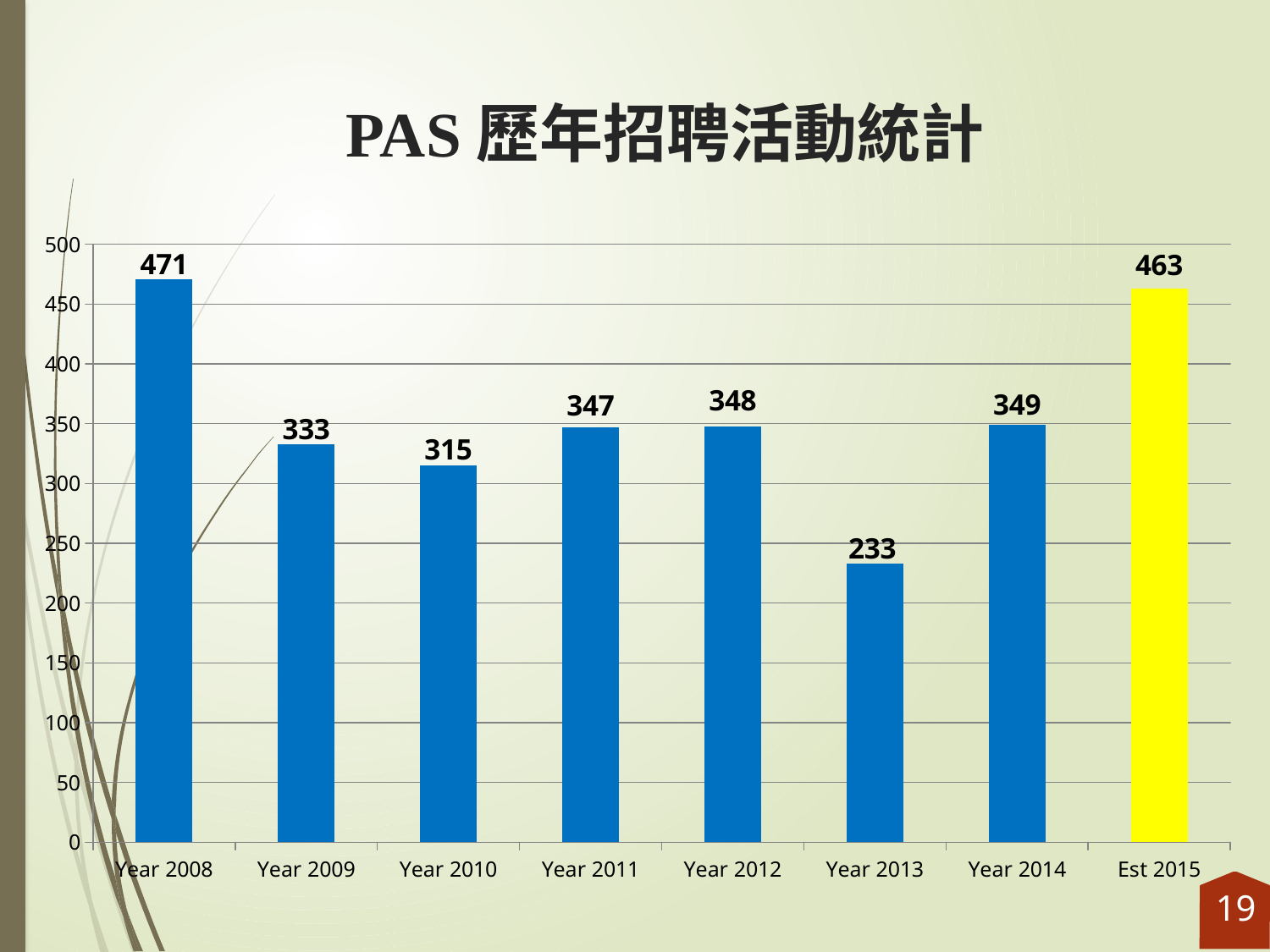
What is the value for Est 2015? 463 What is the value for Year 2008? 471 Is the value for Year 2011 greater or less than 300? greater Which category has the highest value? Year 2008 What kind of chart is shown on the slide? bar chart Which is larger, the value for Year 2009 or the value for Year 2010? Year 2009 What is the value for Year 2013? 233 How many categories are shown on the x axis? 8 What is the difference between the values for Year 2014 and Year 2013? 116 Which bar is coloured yellow instead of blue? Est 2015 What is the difference between the values for Year 2008 and Est 2015? 8 Which category has the lowest value? Year 2013